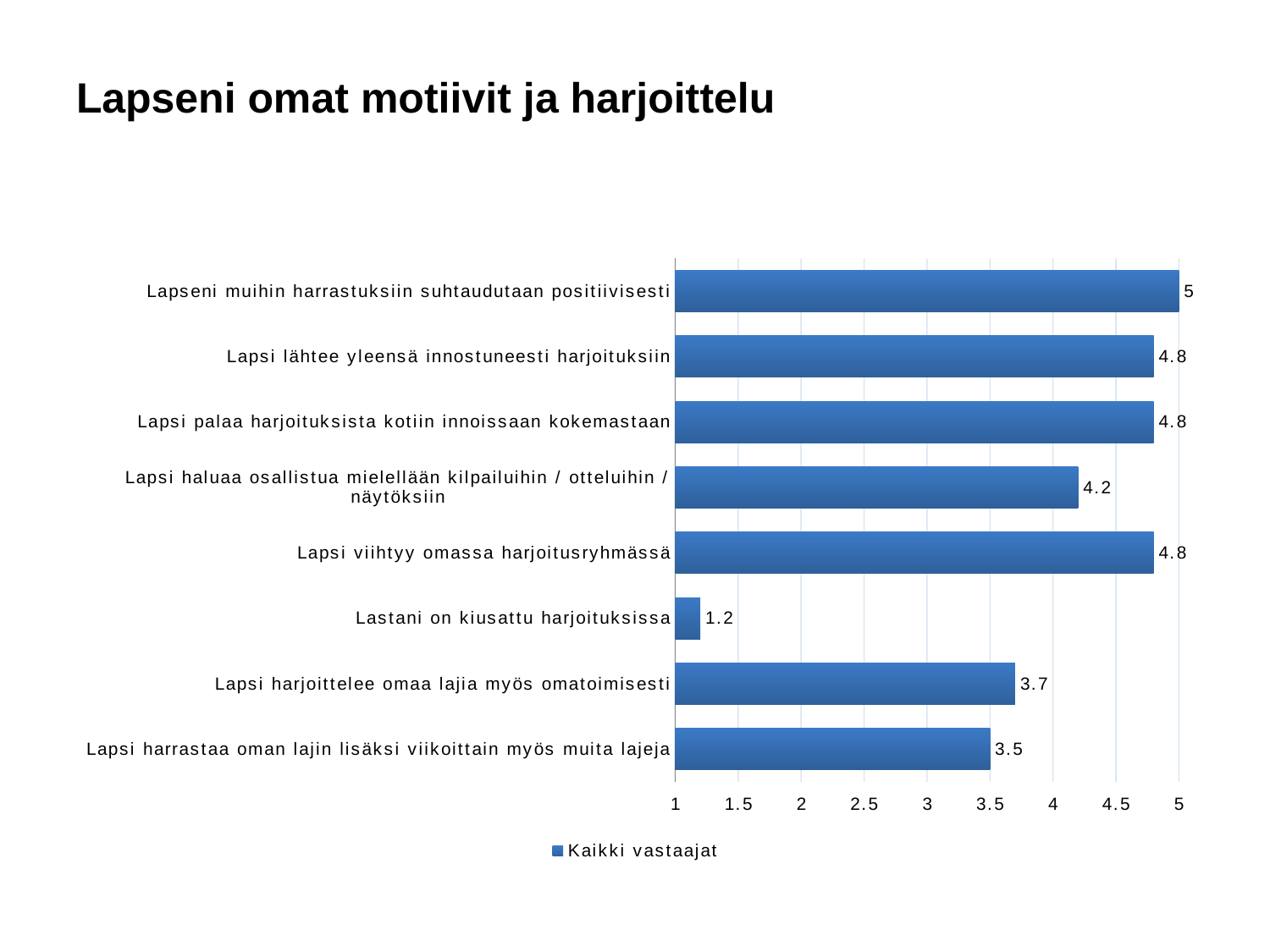
Which category has the highest value? Lapseni muihin harrastuksiin suhtaudutaan positiivisesti What kind of chart is shown on the slide? Bar chart Which category has the lowest value? Lastani on kiusattu harjoituksissa What is the difference between the values for "Lapsi lähtee yleensä innostuneesti harjoituksiin" and "Lapsi harrastaa oman lajin lisäksi viikoittain myös muita lajeja"? 1.3 How many series does the legend list? 1 What is the value for "Lapsi haluaa osallistua mielellään kilpailuihin / otteluihin / näytöksiin"? 4.2 What is the name of the series shown in the legend? Kaikki vastaajat How many categories are shown in the chart? 8 Is the value for "Lapsi viihtyy omassa harjoitusryhmässä" greater or less than 4? greater Which is larger: the value for "Lapsi harjoittelee omaa lajia myös omatoimisesti" or for "Lapsi harrastaa oman lajin lisäksi viikoittain myös muita lajeja"? Lapsi harjoittelee omaa lajia myös omatoimisesti What is the value for "Lastani on kiusattu harjoituksissa"? 1.2 What is the value for "Lapsi harjoittelee omaa lajia myös omatoimisesti"? 3.7